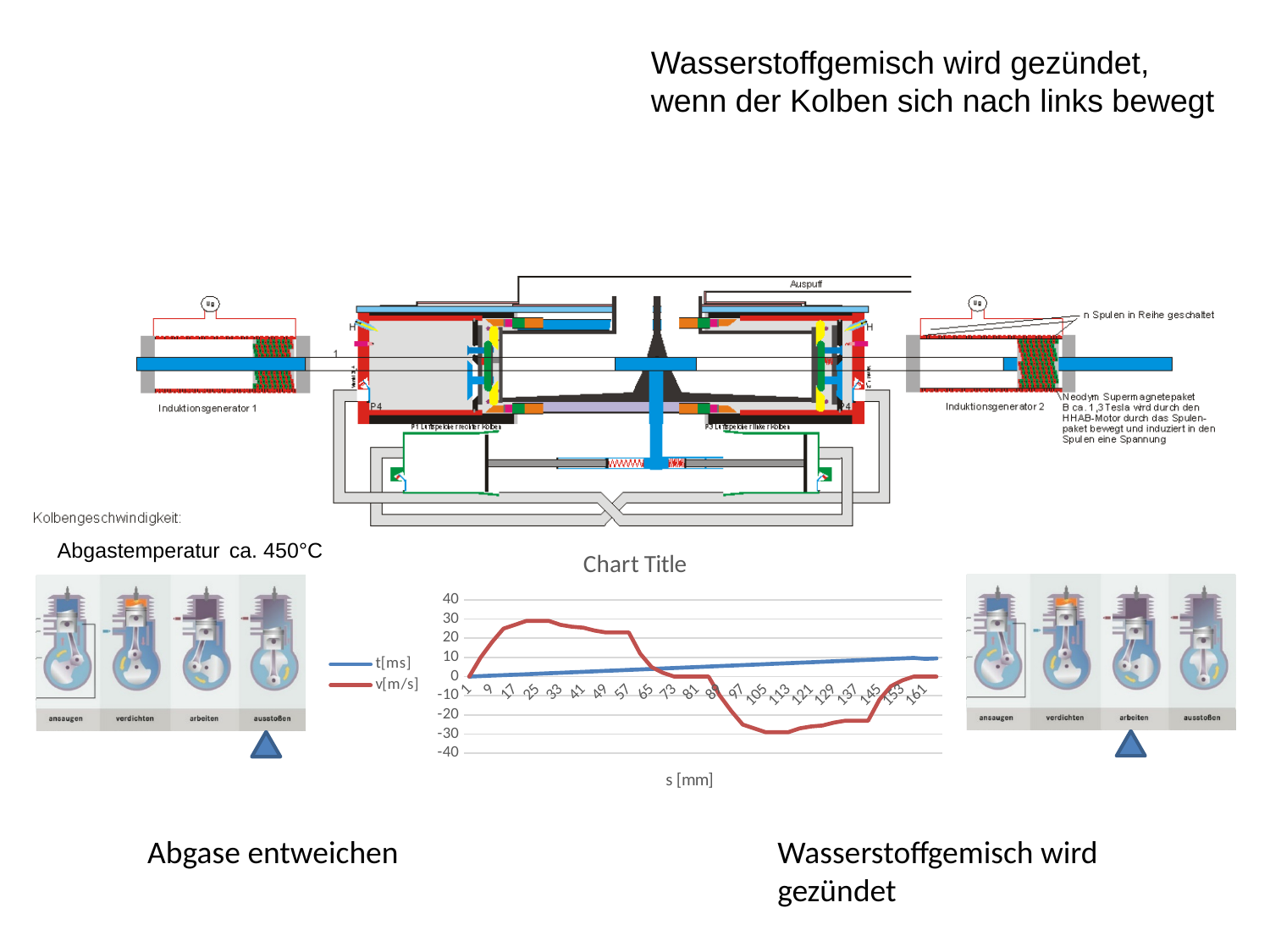
What are the two series named in the chart legend? t[ms] and v[m/s] Is the value of v[m/s] at s = 121 greater or less than -10? less Is the value of v[m/s] at s = 33 greater or less than 20? greater Is the value of v[m/s] at s = 105 greater or less than -20? less How many series does the legend of the chart list? 2 What is the label of the x axis of the chart? s [mm] What kind of chart is shown under the heading 'Chart Title'? line chart Which series reaches the lowest value on the chart, t[ms] or v[m/s]? v[m/s] How many tick labels are shown on the x axis of the chart? 21 Which series reaches the highest value on the chart, t[ms] or v[m/s]? v[m/s] Does the t[ms] series rise or fall as s increases along the x axis? rise